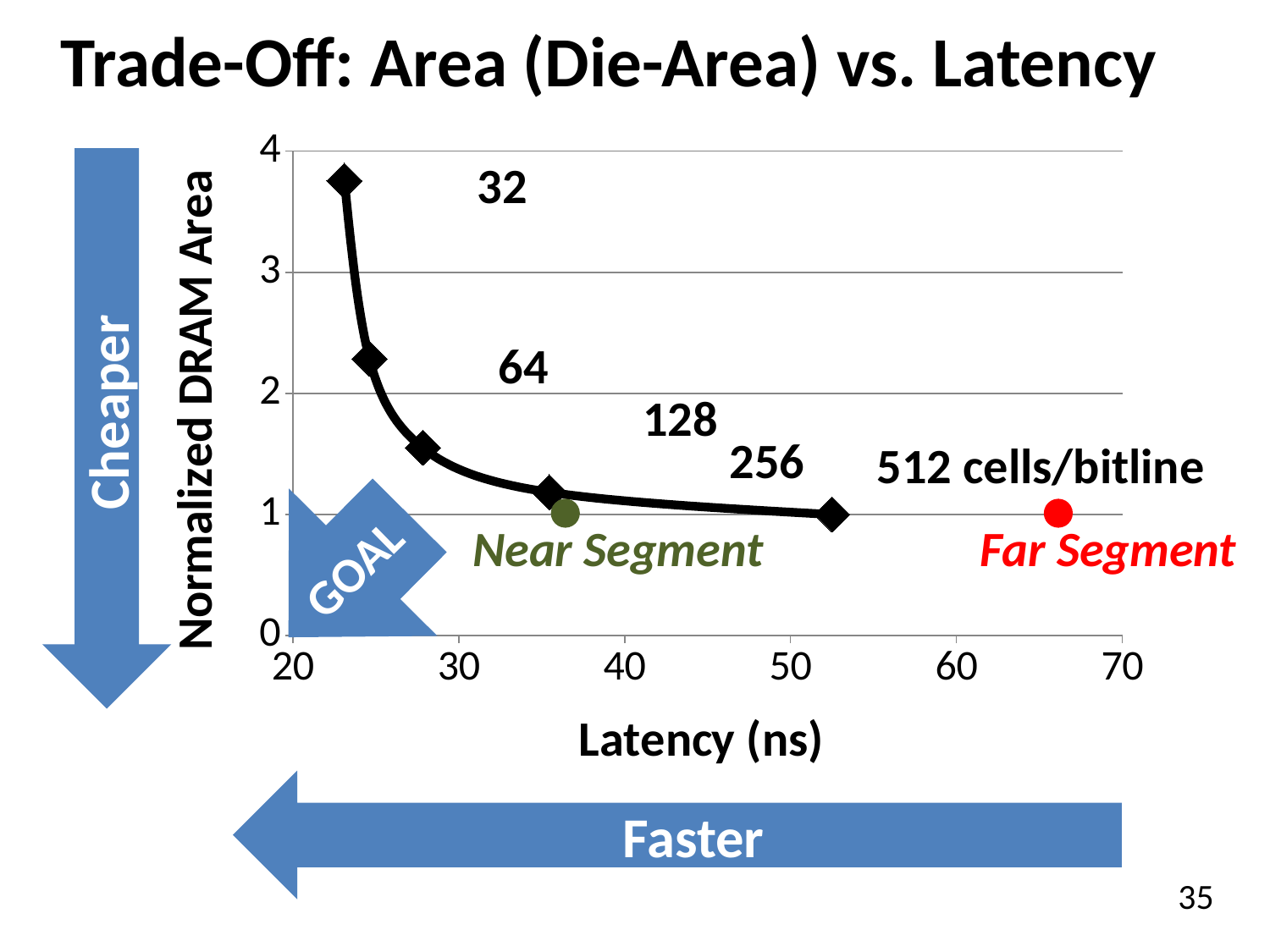
Is the normalized DRAM area for 32 cells/bitline greater or less than 3? greater Which cells/bitline configuration has the highest normalized DRAM area? 32 Is the latency of the Far Segment point greater or less than 60 ns? greater Is the normalized DRAM area for 64 cells/bitline greater or less than 2? greater What is the title of the chart on the slide? Trade-Off: Area (Die-Area) vs. Latency Which has the lower latency, the Near Segment point or the Far Segment point? Near Segment Which cells/bitline configuration has the lowest normalized DRAM area? 512 What is the label of the x axis? Latency (ns) How many black diamond data points are plotted on the curve? 5 As latency increases along the x axis, does the normalized DRAM area rise or fall? fall Which has the higher normalized DRAM area, 64 cells/bitline or 256 cells/bitline? 64 cells/bitline